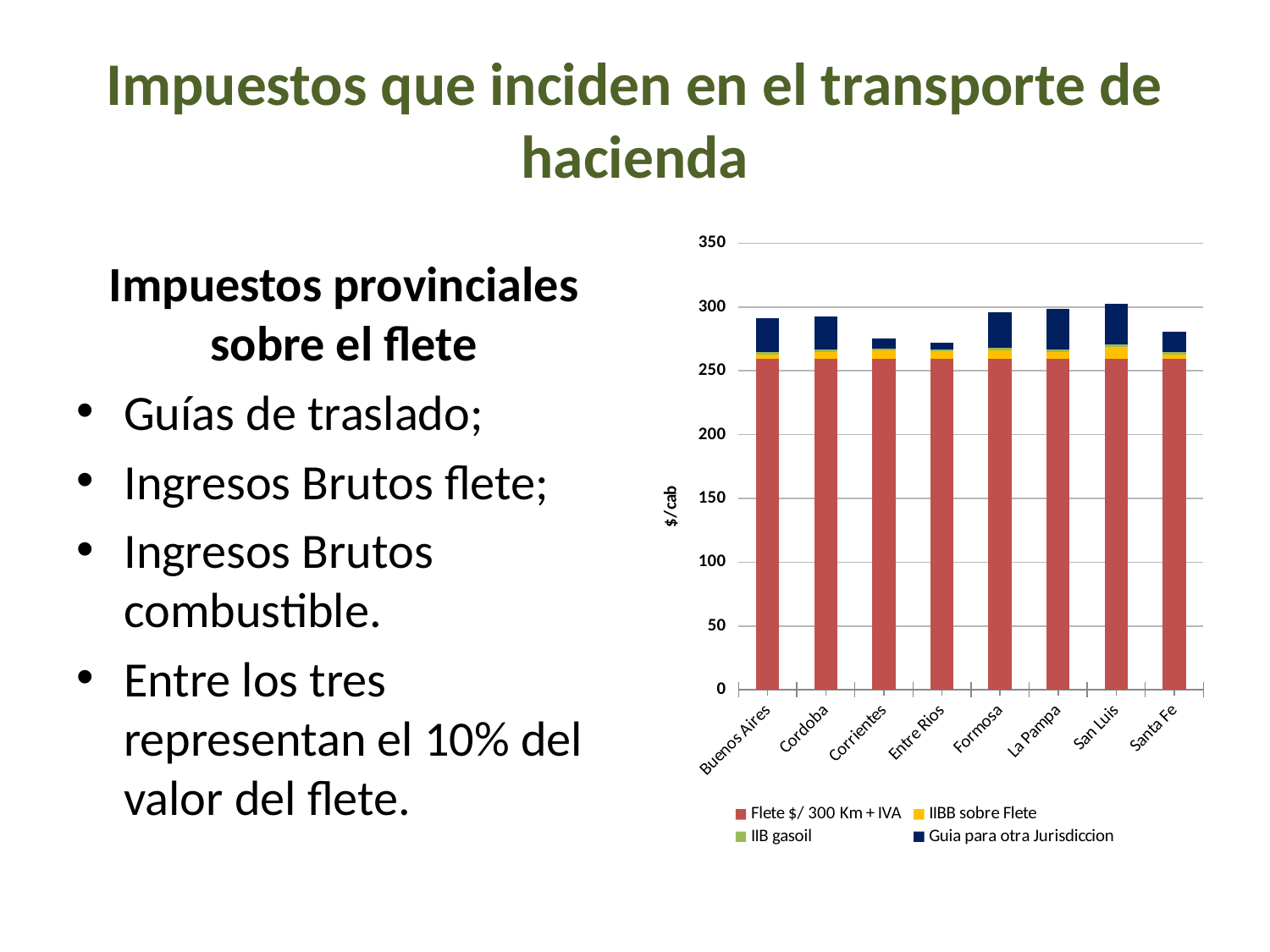
Which has the larger total bar, San Luis or Entre Rios? San Luis What kind of chart is shown on the slide? Stacked bar chart How many series does the chart's legend list? 4 Is the total value for Corrientes greater or less than 250? greater Is the total value for Santa Fe greater or less than 300? less How many provinces are shown on the x axis of the chart? 8 Which province has the tallest stacked bar in the chart? San Luis Which has the larger total bar, Formosa or Corrientes? Formosa What is the label on the chart's vertical axis? $/ cab Is the total value for Buenos Aires greater or less than 250? greater Which series in the legend is shown in red and makes up the largest part of each bar? Flete $/ 300 Km + IVA